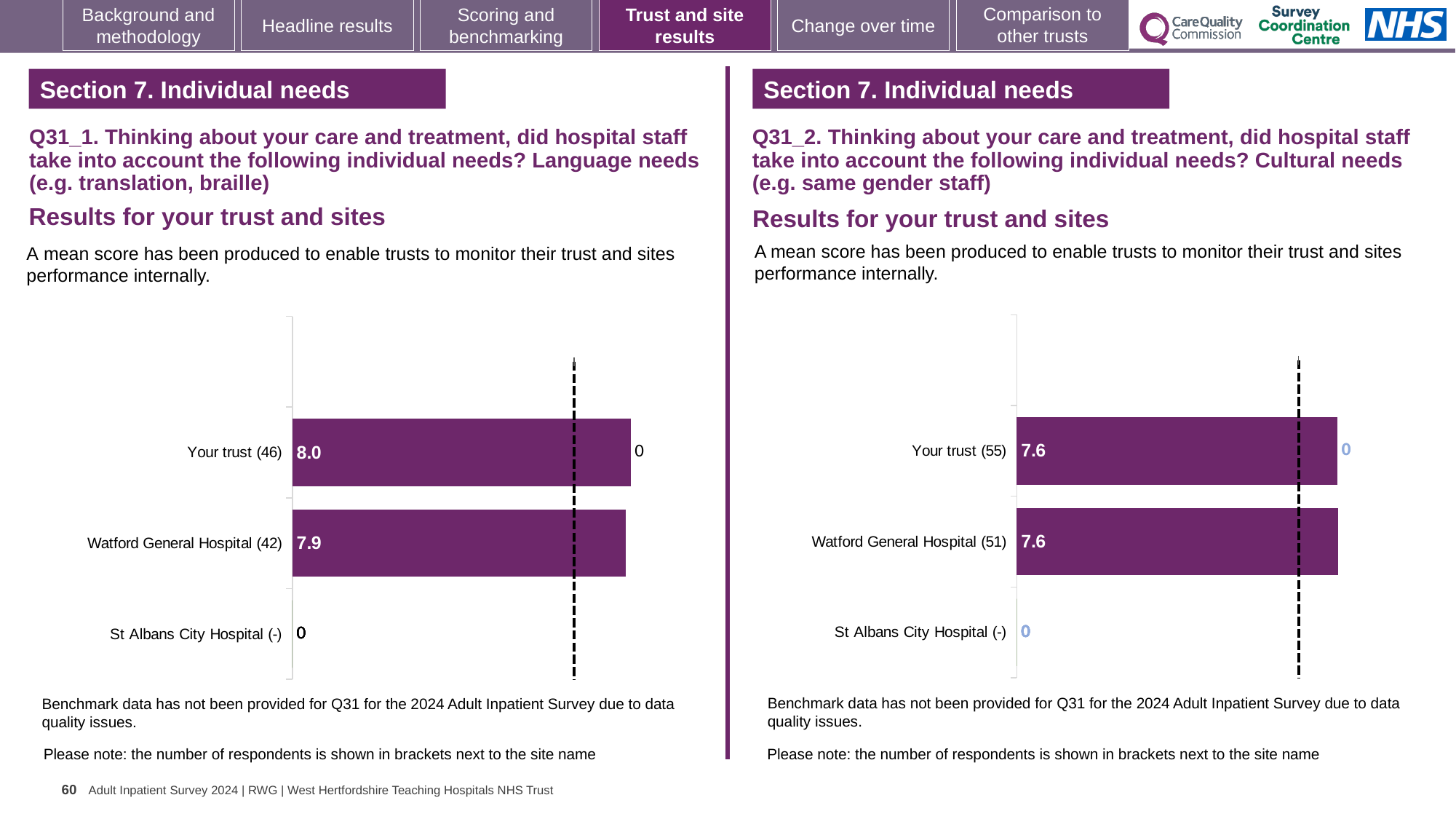
On the left chart (Q31_1, Language needs), what is the difference between the scores for Your trust and Watford General Hospital? 0.1 On the right chart (Q31_2, Cultural needs), which category has the lowest value? St Albans City Hospital On the right chart (Q31_2, Cultural needs), what is the mean score for Watford General Hospital? 7.6 On the left chart (Q31_1, Language needs), what is the mean score for Your trust? 8.0 On the left chart (Q31_1, Language needs), which category has the highest mean score? Your trust On the left chart (Q31_1, Language needs), how many respondents are shown in brackets for Your trust? 46 On the right chart (Q31_2, Cultural needs), what is the mean score for Your trust? 7.6 On the left chart (Q31_1, Language needs), which is larger: the score for Your trust or for Watford General Hospital? Your trust What kind of chart is used on the left (Q31_1, Language needs)? Bar chart On the right chart (Q31_2, Cultural needs), how many respondents are shown in brackets for Watford General Hospital? 51 On the left chart (Q31_1, Language needs), what is the mean score for Watford General Hospital? 7.9 How many categories are shown on the right chart (Q31_2, Cultural needs)? 3